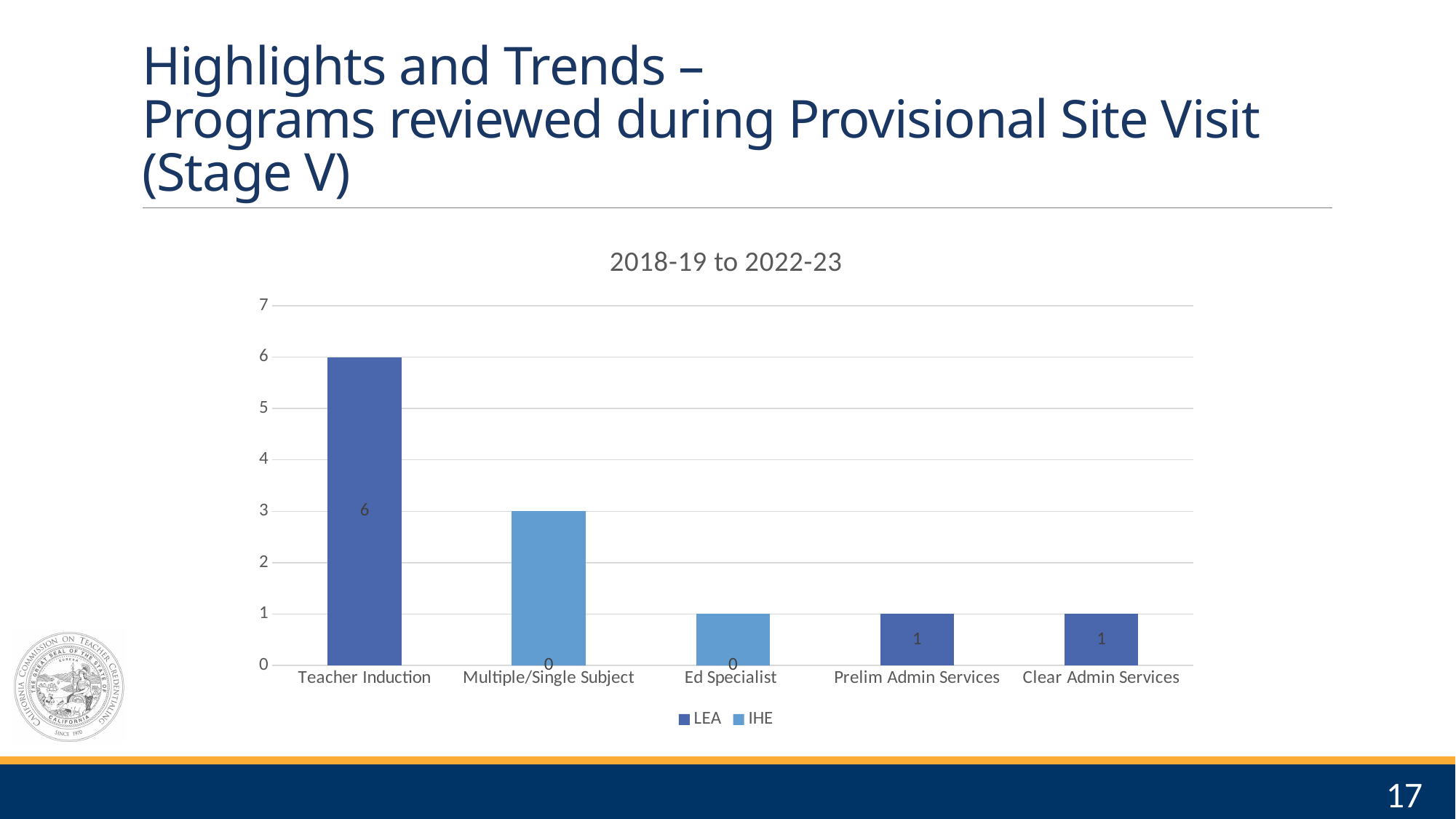
What is the LEA value for Teacher Induction? 6 What type of chart is shown on the slide? bar chart Which is larger: the IHE value for Multiple/Single Subject or the IHE value for Ed Specialist? Multiple/Single Subject Which category has the tallest bar in the chart? Teacher Induction What is the LEA value for Multiple/Single Subject? 0 What is the difference between the LEA value for Teacher Induction and the IHE value for Multiple/Single Subject? 3 What is the LEA value for Prelim Admin Services? 1 What is the IHE value for Multiple/Single Subject? 3 Is the LEA value for Teacher Induction greater or less than 5? greater How many series does the chart legend list? 2 What is the IHE value for Ed Specialist? 1 How many categories are shown on the x axis of the chart? 5